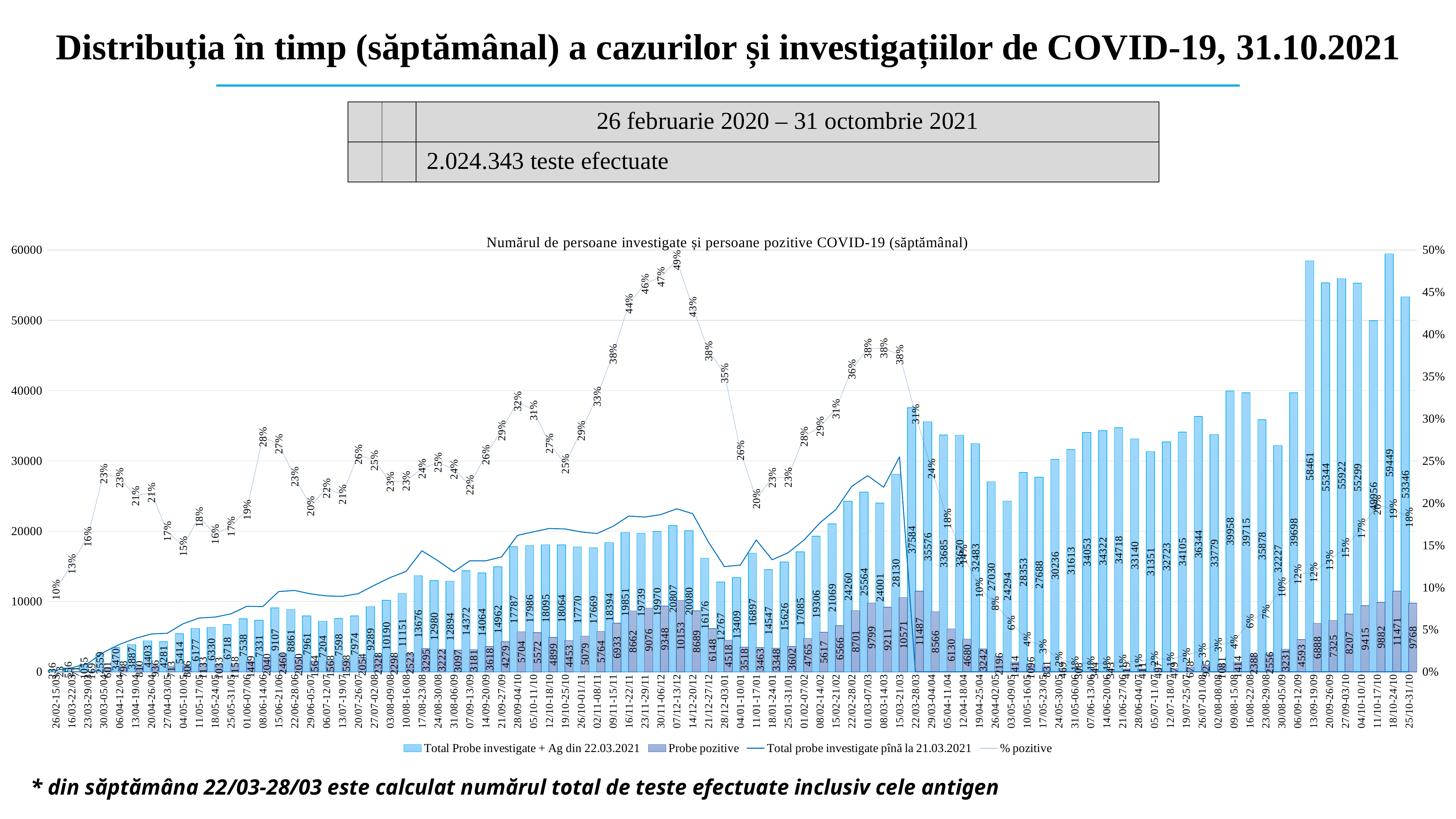
Which week has a larger total probes investigated bar: 13/09-19/09 or 20/09-26/09? 13/09-19/09 What is the value of 'Probe pozitive' for the week 25/10-31/10? 9768 What is the title of the chart? Numărul de persoane investigate și persoane pozitive COVID-19 (săptămânal) Which week has the highest 'Total Probe investigate + Ag din 22.03.2021' bar? 18/10-24/10 How many series does the chart legend list? 4 From week 06/09-12/09 to week 11/10-17/10, does the '% pozitive' line rise or fall? rise What is the highest '% pozitive' value shown on the chart? 49% What is the '% pozitive' value for the week 22/03-28/03? 31% What is the value of 'Total Probe investigate + Ag din 22.03.2021' for the week 18/10-24/10? 59449 What is the difference between the total probes investigated in week 18/10-24/10 and week 25/10-31/10? 6103 What is the maximum value shown on the right-hand percentage axis? 50% Is the total probes investigated value for week 25/10-31/10 greater or less than 50000? greater